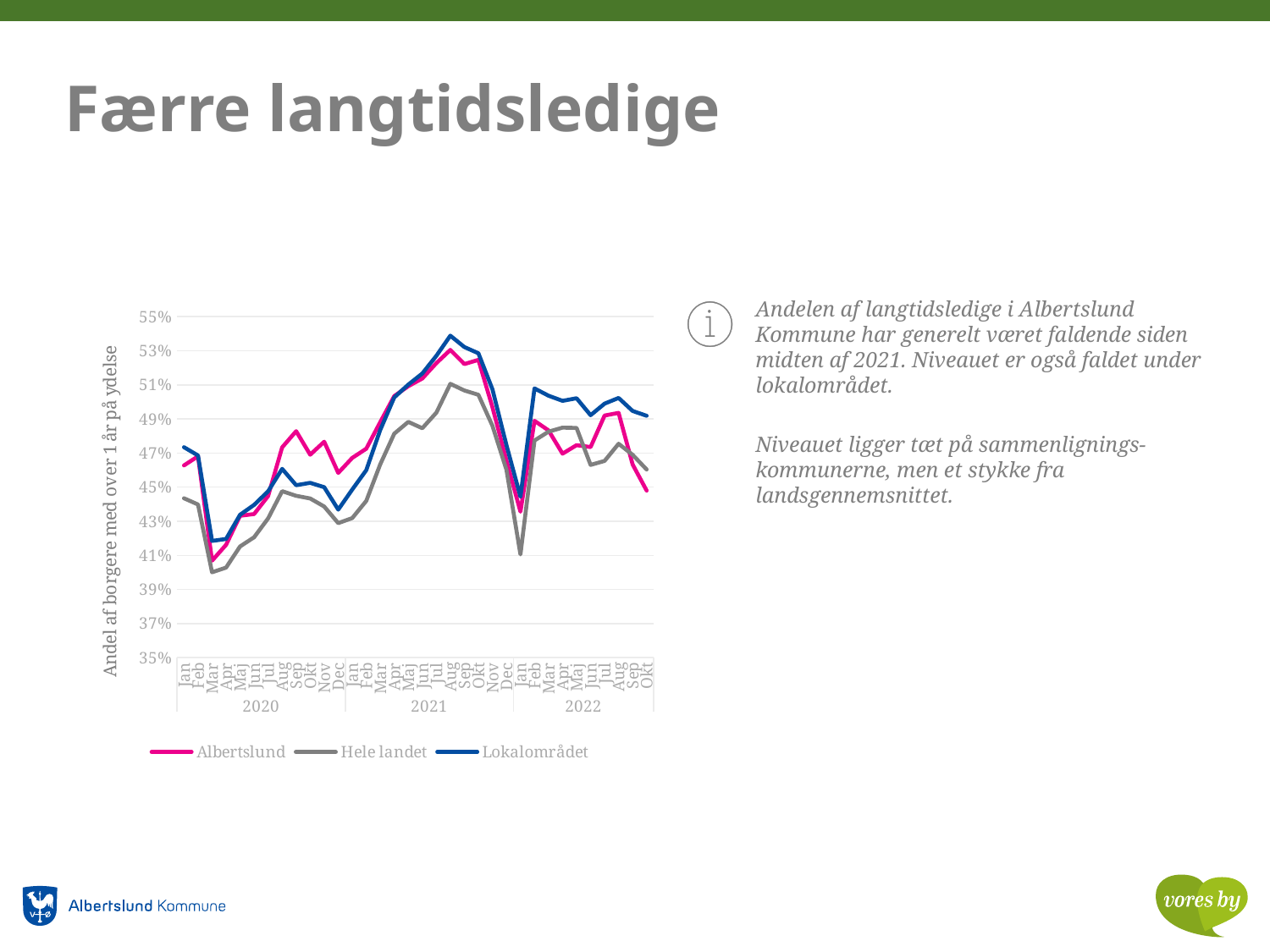
In Okt 2022, which is larger: the value for Albertslund or the value for Lokalområdet? Lokalområdet How many years are labelled along the x axis of the chart? 3 What kind of chart is shown on the slide? Line chart Is the value for Albertslund in Okt 2022 greater or less than 47%? less Does the Albertslund series rise or fall from Aug 2022 to Okt 2022? Fall Is the value for Hele landet in Jan 2022 greater or less than 43%? less What is the label on the vertical axis of the chart? Andel af borgere med over 1 år på ydelse Which series is shown in grey in the chart? Hele landet How many series does the chart legend list? 3 Which series has the highest value in Aug 2021? Lokalområdet Is the value for Lokalområdet in Aug 2021 greater or less than 51%? greater